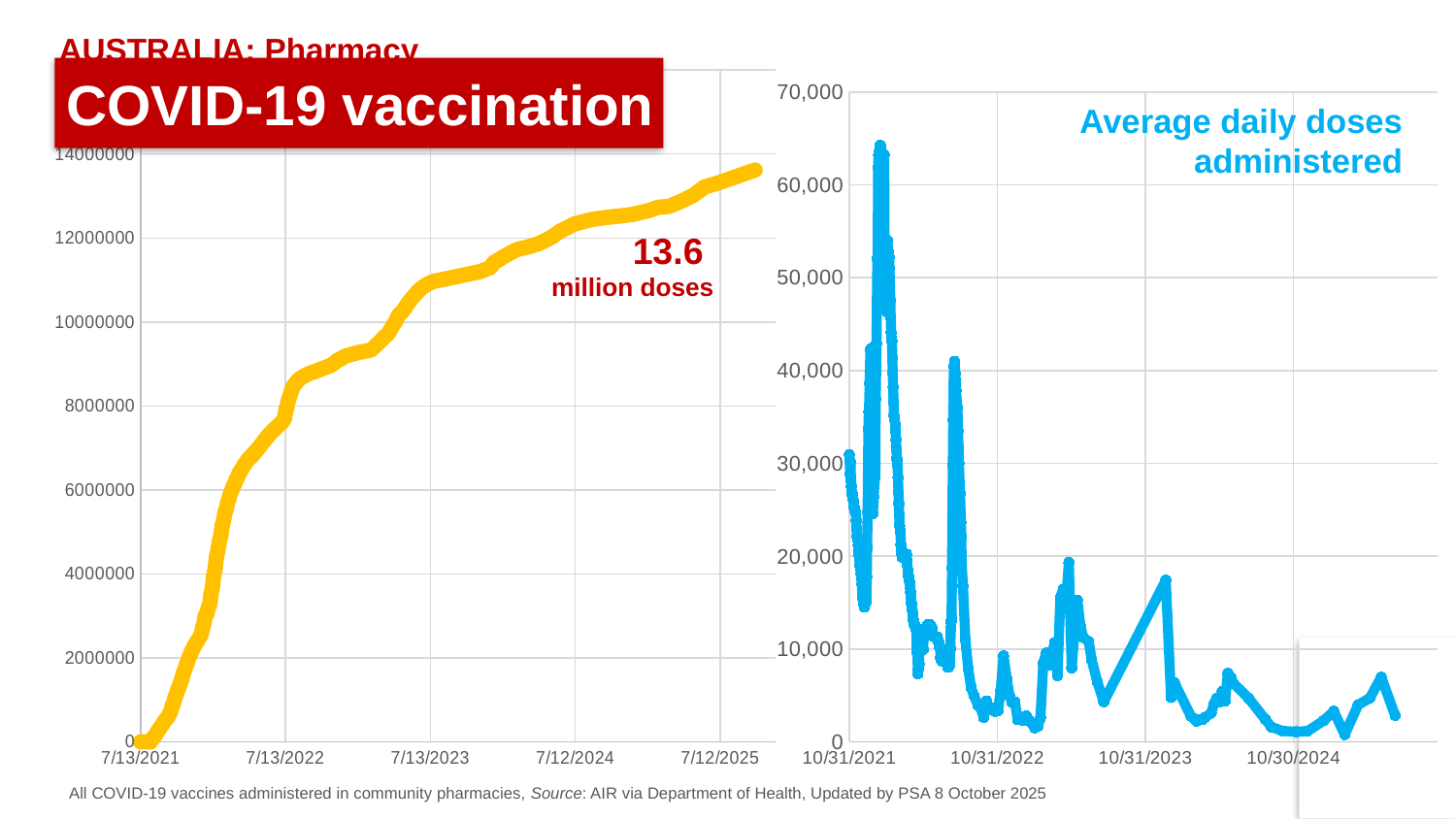
On the right 'Average daily doses administered' chart, do the values overall rise or fall from 10/31/2021 to the end of the series? fall On the right 'Average daily doses administered' chart, is the highest peak greater or less than 60,000? greater How many date labels are shown on the x axis of the left cumulative doses chart? 5 What colour is the line on the right 'Average daily doses administered' chart? blue On the left cumulative doses chart, is the value at 7/13/2023 greater or less than 10000000? greater What kind of chart is the left chart showing cumulative COVID-19 vaccination doses? line chart On the left cumulative doses chart, do the values rise or fall from 7/13/2021 to 7/12/2025? rise On the right 'Average daily doses administered' chart, which is larger: the peak shortly after 10/31/2021 or the peak shortly after 10/31/2022? the peak shortly after 10/31/2021 On the right 'Average daily doses administered' chart, is the value at 10/30/2024 greater or less than 10,000? less What kind of chart is the right chart titled 'Average daily doses administered'? line chart On the left cumulative doses chart, what total number of doses is annotated at the end of the line? 13.6 million doses